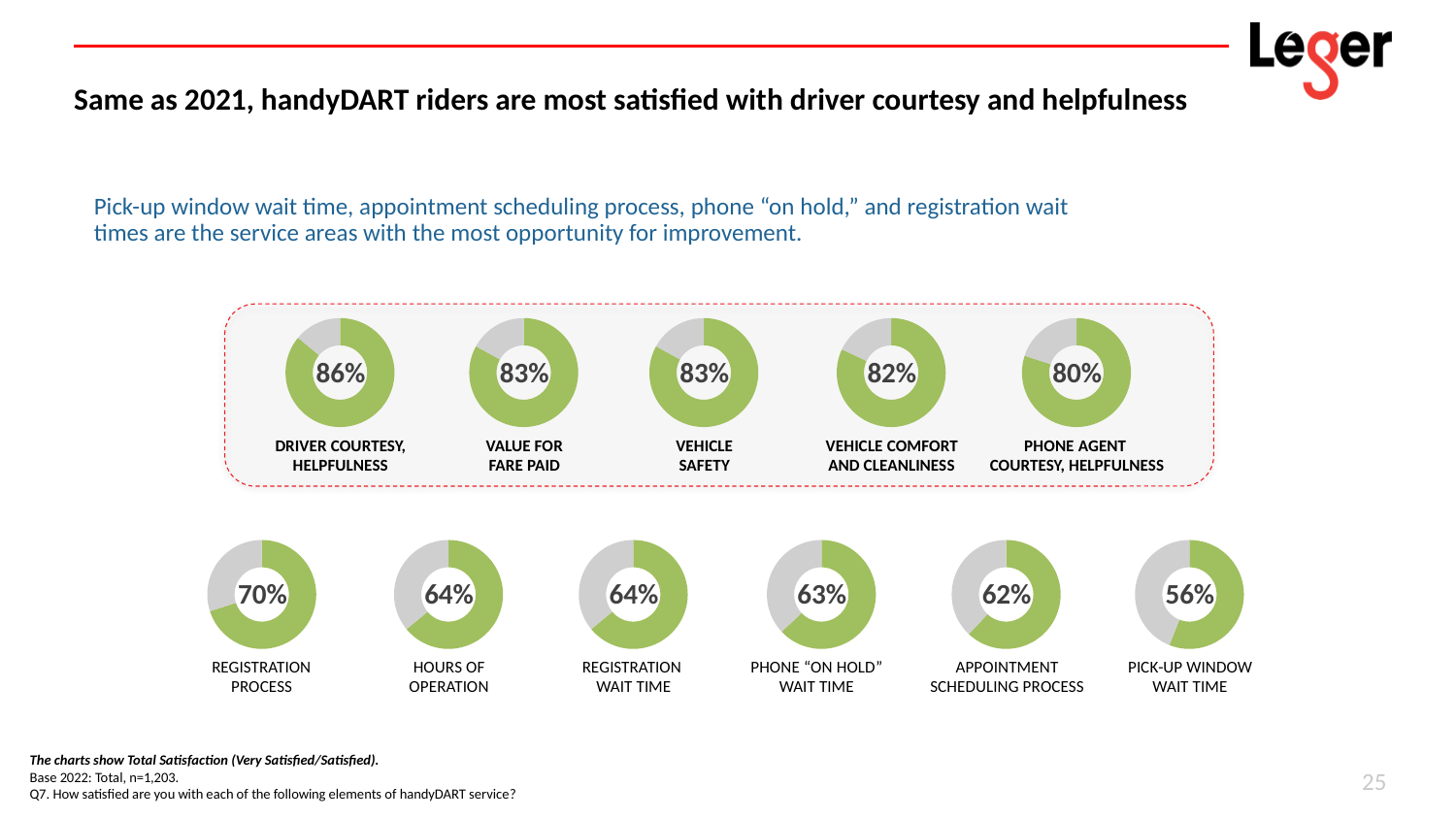
What is the satisfaction value shown in the Phone Agent Courtesy, Helpfulness donut chart? 80% Across all the donut charts on the slide, which service element has the lowest satisfaction value? Pick-Up Window Wait Time What is the satisfaction value shown in the Appointment Scheduling Process donut chart? 62% Which has a higher satisfaction value: Vehicle Comfort and Cleanliness or Hours of Operation? Vehicle Comfort and Cleanliness What is the difference between the Registration Process value and the Phone "On Hold" Wait Time value? 7% What type of chart is used to display each satisfaction value on the slide? Donut (pie) chart How many donut charts are shown on the slide in total? 11 What is the satisfaction value shown in the Driver Courtesy, Helpfulness donut chart? 86% What is the satisfaction value shown in the Pick-Up Window Wait Time donut chart? 56% What is the satisfaction value shown in the Registration Process donut chart? 70% Across all the donut charts on the slide, which service element has the highest satisfaction value? Driver Courtesy, Helpfulness What is the difference between the Driver Courtesy, Helpfulness value and the Pick-Up Window Wait Time value? 30%